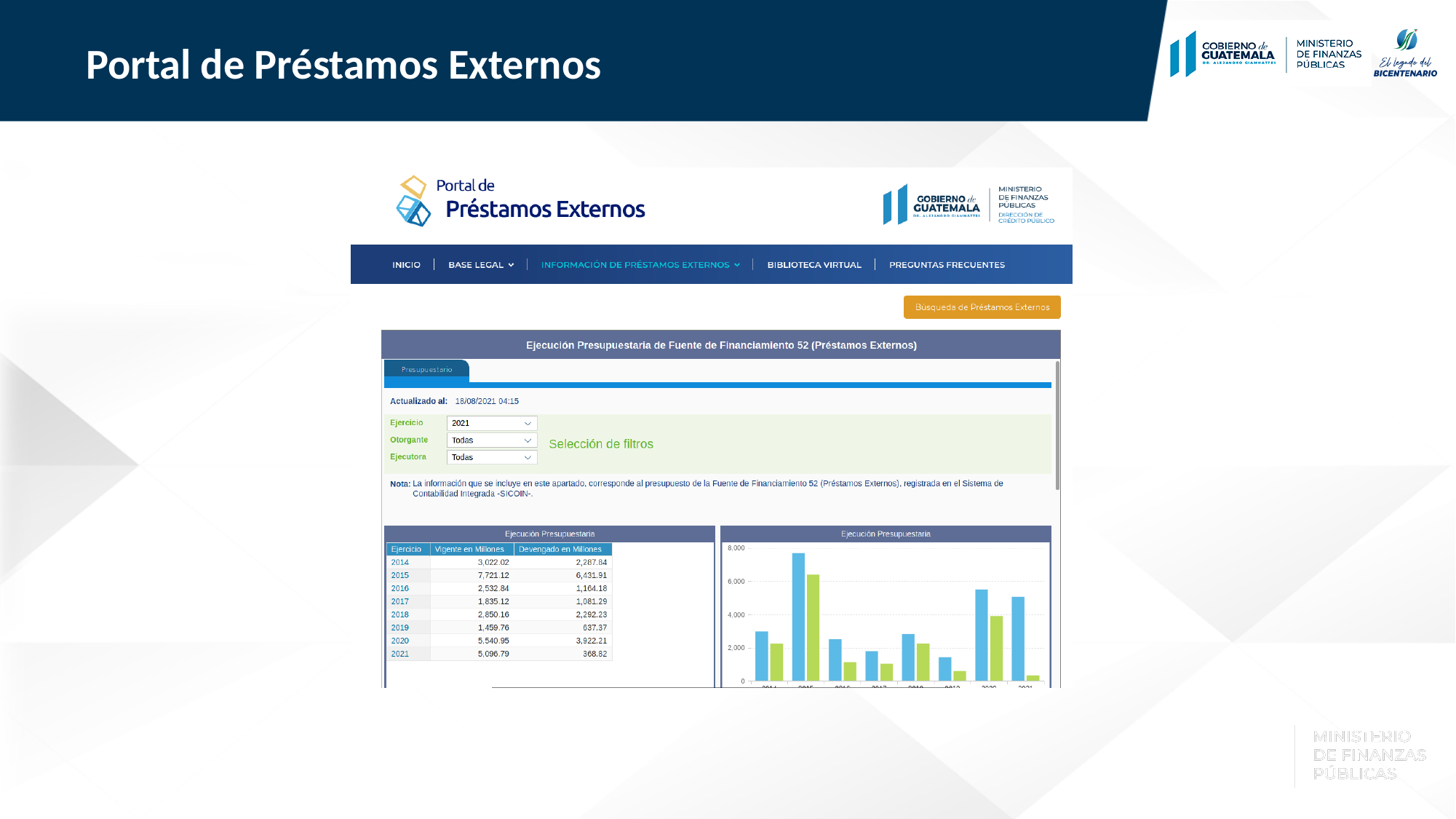
In the 'Ejecución Presupuestaria' bar chart, which is taller: the green bar for 2014 or the green bar for 2016? 2014 According to the 'Ejecución Presupuestaria' table next to the chart, what is the 'Vigente en Millones' value for 2015? 7,721.12 In the 'Ejecución Presupuestaria' bar chart, which is taller: the blue bar for 2015 or the blue bar for 2020? 2015 What two colours are used for the bars in the 'Ejecución Presupuestaria' bar chart? blue and green What is the title shown above the bar chart on the right side of the screenshot? Ejecución Presupuestaria In the 'Ejecución Presupuestaria' bar chart, which year has the tallest blue bar? 2015 What kind of chart is shown in the 'Ejecución Presupuestaria' panel on the right of the screenshot? bar chart How many years (categories) are plotted along the x axis of the 'Ejecución Presupuestaria' bar chart? 8 In the 'Ejecución Presupuestaria' bar chart, which year has the shortest green bar? 2021 In the 'Ejecución Presupuestaria' bar chart, is the green bar for 2019 greater or less than 2,000? less In the 'Ejecución Presupuestaria' bar chart, is the blue bar for 2014 greater or less than 2,000? greater In the 'Ejecución Presupuestaria' bar chart, is the blue bar for 2015 greater or less than 6,000? greater